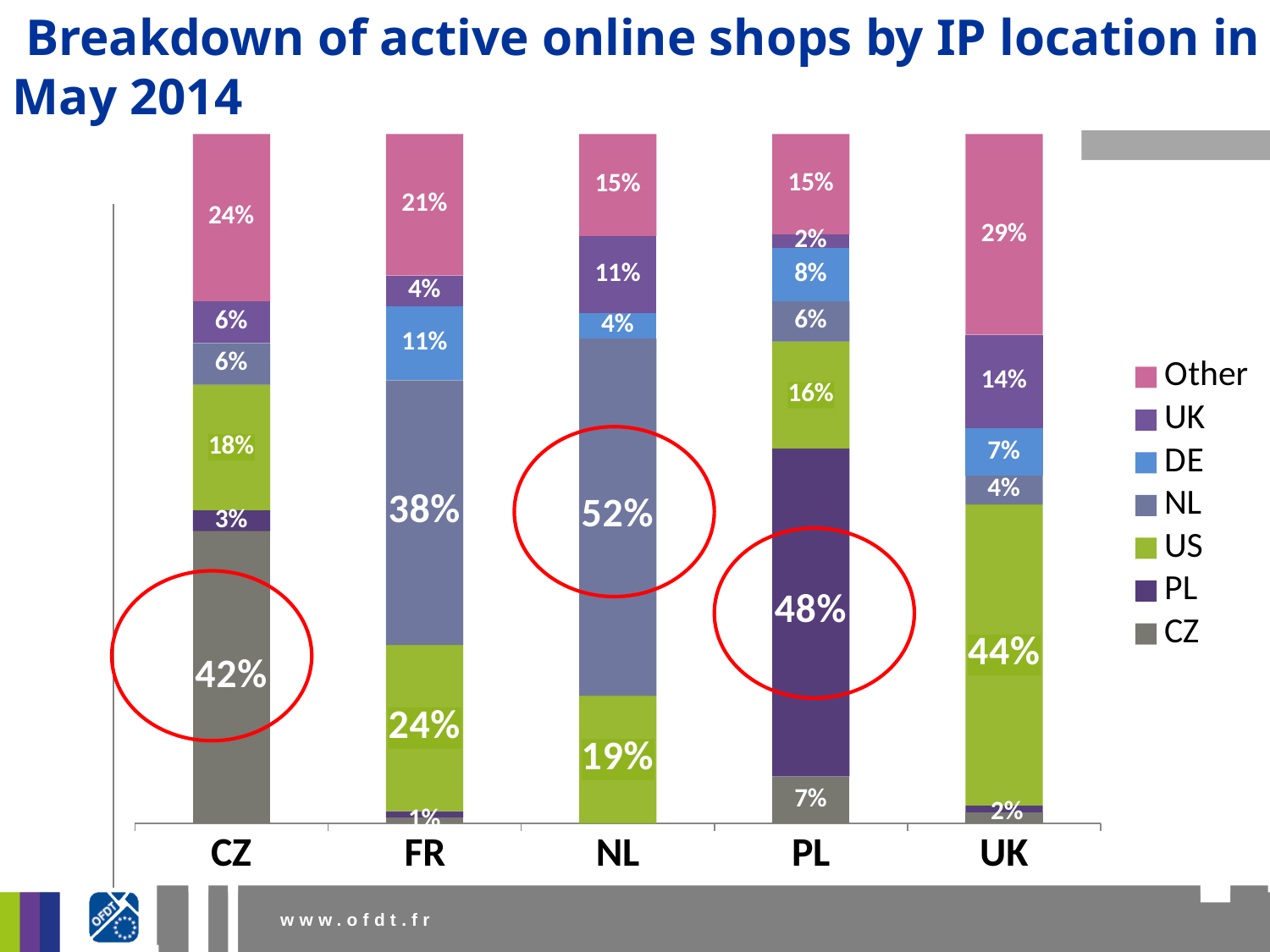
How many percentage points larger is the 'Other' share in the CZ bar than in the FR bar? 3 percentage points What is the 'Other' share in the UK bar? 29% Which country bar has the largest 'Other' segment? UK How many country bars are shown on the x axis? 5 How many series does the legend list? 7 What is the NL share in the NL bar? 52% What is the US share in the UK bar? 44% What is the NL share in the FR bar? 38% What is the PL share in the PL bar? 48% What percentage of active online shops in the CZ bar are located in CZ? 42% What kind of chart is shown on the slide? Stacked bar chart Is the US share larger in the FR bar or in the NL bar? FR